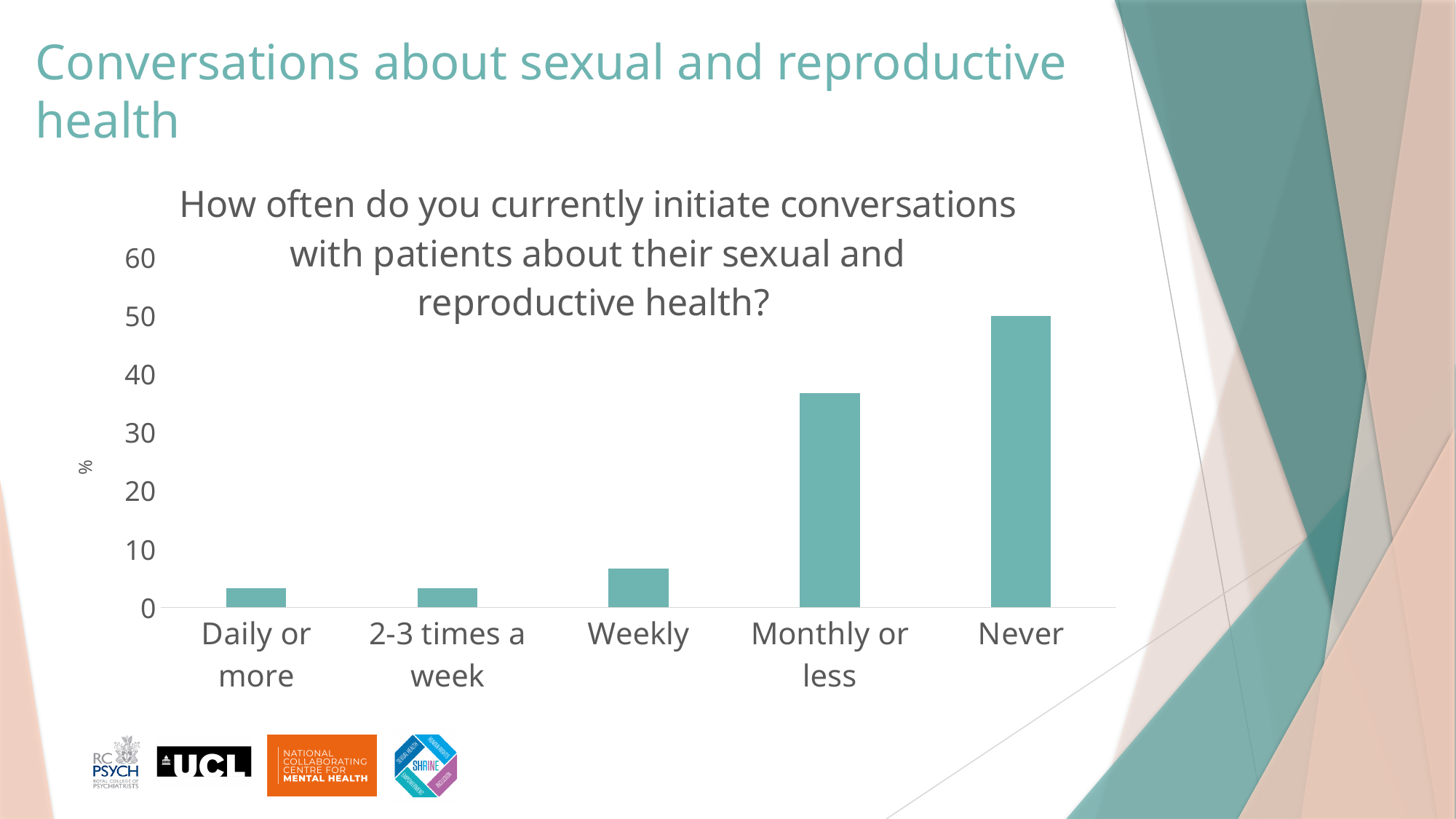
Do the values generally rise or fall moving from left to right along the x axis? Rise Is the value for Monthly or less greater or less than 40? less Which category has the highest value in the chart? Never Is the value for Daily or more greater or less than 10? less What is the label on the vertical axis of the chart? % Is the value for Weekly greater or less than 10? less Which is larger, the value for Never or the value for Monthly or less? Never Which is larger, the value for Monthly or less or the value for Weekly? Monthly or less What kind of chart is shown on the slide? Bar chart How many categories are shown on the x axis of the chart? 5